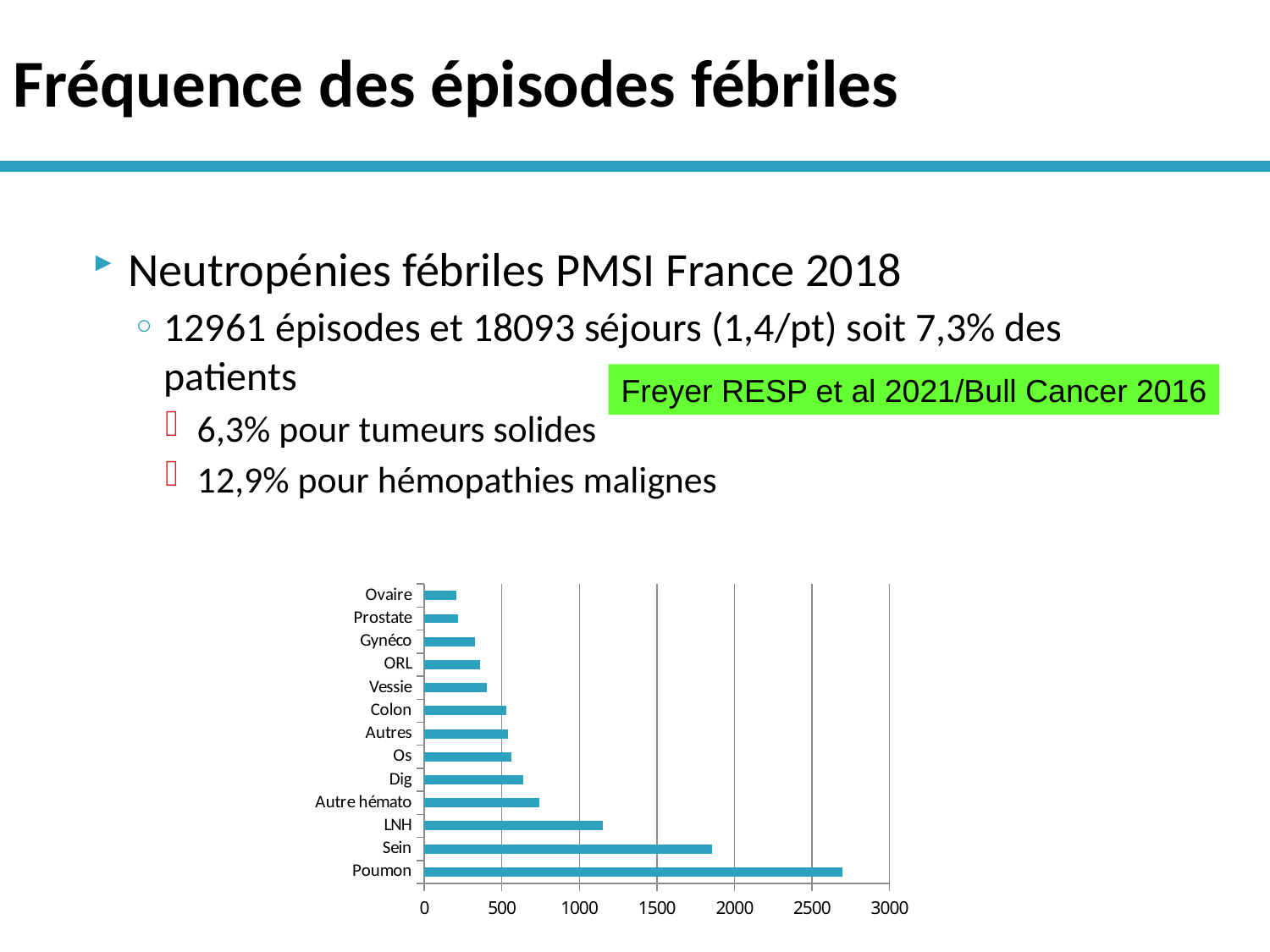
Is the value for Vessie greater or less than 500? less Which has a larger value, Sein or LNH? Sein What is the maximum value shown on the horizontal axis of the bar chart? 3000 What kind of chart is shown on the slide? bar chart Is the value for LNH greater or less than 1000? greater Which has a larger value, Autre hémato or Dig? Autre hémato Is the value for Autre hémato greater or less than 1000? less Which category has the highest value in the bar chart? Poumon How many categories are plotted in the bar chart? 13 Which category is listed at the top of the bar chart? Ovaire